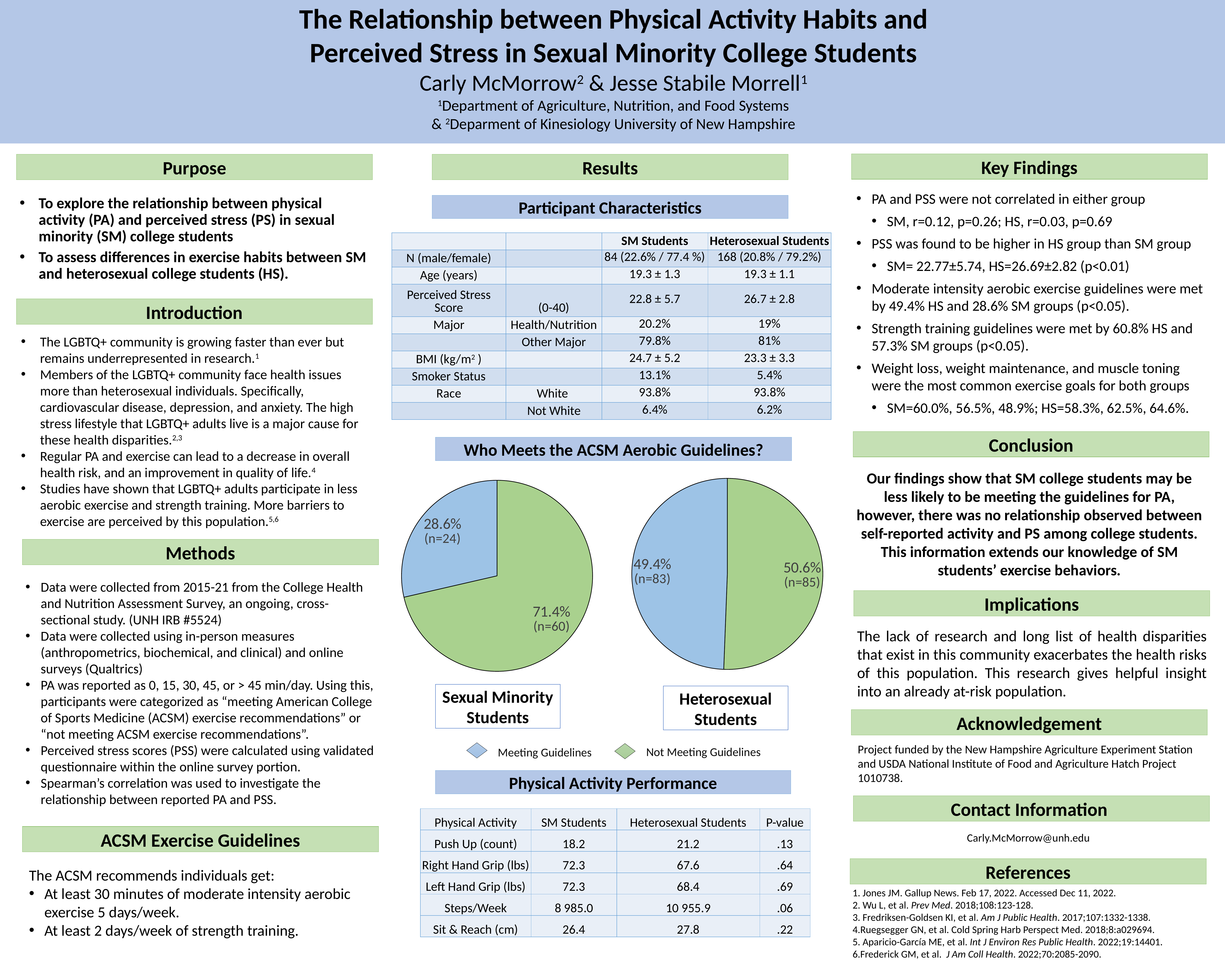
In the Sexual Minority Students pie chart, what share of students are meeting the ACSM aerobic guidelines? 28.6% In the ACSM aerobic guidelines pie charts, which colour represents Meeting Guidelines? Blue In the Heterosexual Students pie chart, how many students (n) are in the Not Meeting Guidelines slice? n=85 In the Sexual Minority Students pie chart, which slice is the largest? Not Meeting Guidelines Which is larger: the Meeting Guidelines share in the Sexual Minority Students pie chart or the Meeting Guidelines share in the Heterosexual Students pie chart? Heterosexual Students What type of chart is used to show who meets the ACSM aerobic guidelines? Pie chart In the Sexual Minority Students pie chart, what share of students are not meeting the ACSM aerobic guidelines? 71.4% In the Sexual Minority Students pie chart, what is the difference in percentage points between the Not Meeting Guidelines and Meeting Guidelines slices? 42.8 In the Heterosexual Students pie chart, what share of students are meeting the ACSM aerobic guidelines? 49.4% In the Sexual Minority Students pie chart, how many students (n) are in the Meeting Guidelines slice? n=24 How many slices does the Heterosexual Students pie chart have? 2